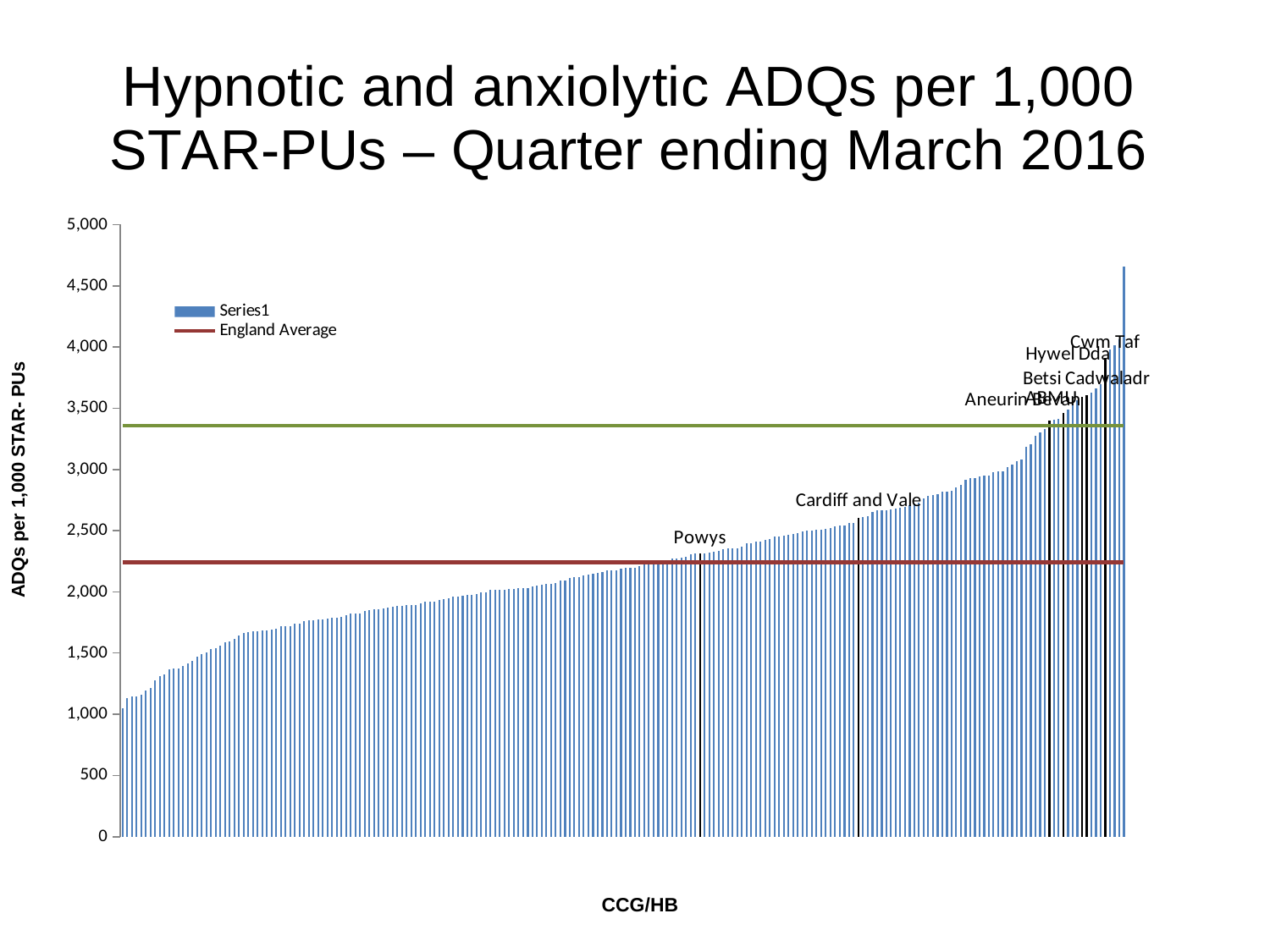
What is the title of the x axis? CCG/HB What kind of chart is shown on the slide? bar chart Is the value for Cwm Taf greater or less than 4,000? less Is the value for Powys greater or less than 3,000? less Is the value for Cardiff and Vale greater or less than 2,000? greater How many entries does the legend list? 2 Of the labelled health boards, which has the lowest value? Powys Which has the larger value, Cardiff and Vale or Powys? Cardiff and Vale Do the bar values rise or fall from left to right along the x axis? rise Which has the larger value, Cwm Taf or Powys? Cwm Taf